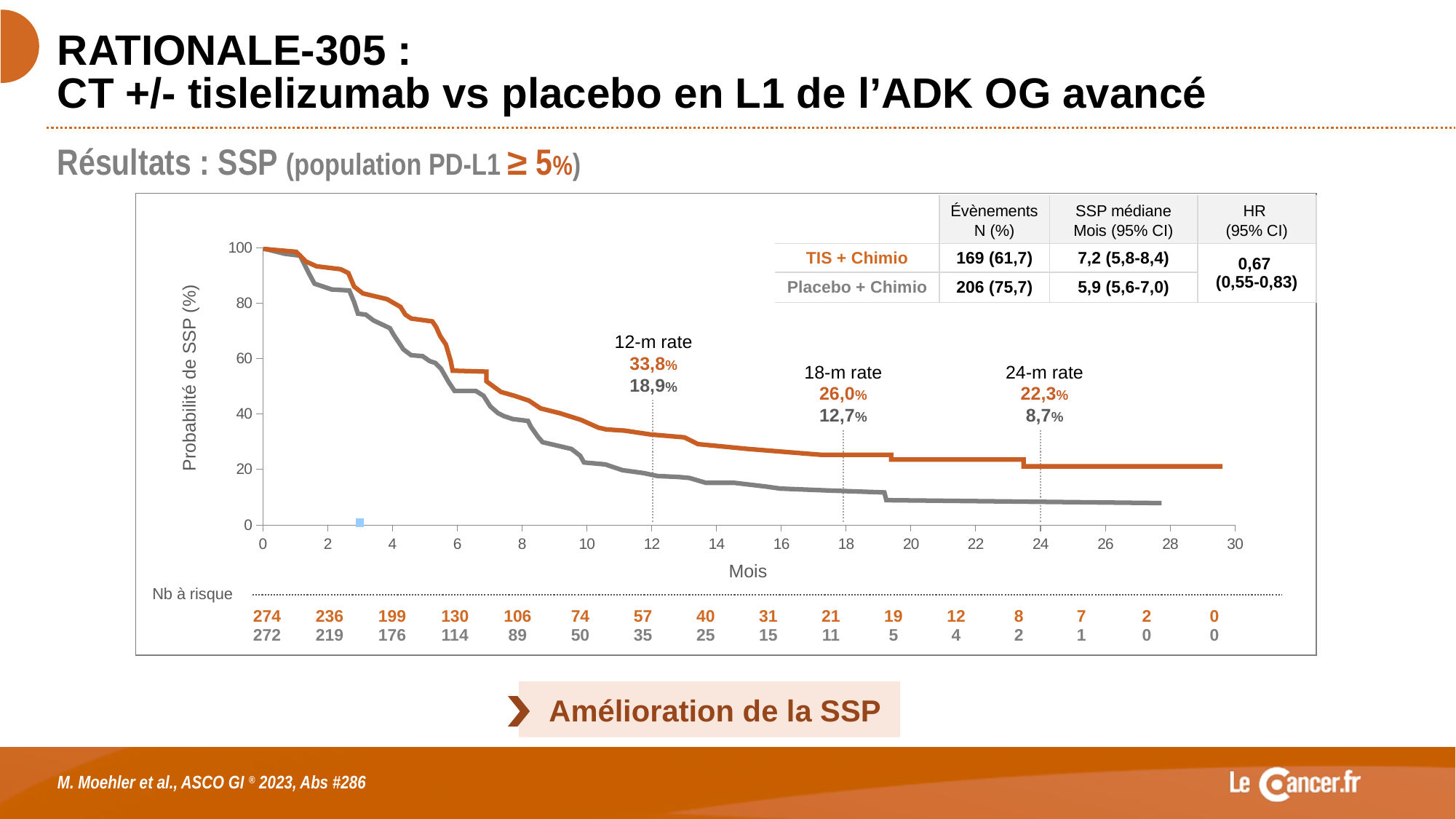
How many patients were at risk in the Placebo + Chimio arm at 10 months? 50 Which arm has the higher number of events, N (%)? Placebo + Chimio Do the SSP probability curves rise or fall along the x axis? fall What is the 12-month SSP rate for the TIS + Chimio arm? 33,8% What is the hazard ratio (95% CI) shown in the table? 0,67 (0,55-0,83) What is the label of the x axis of the chart? Mois How many patients were at risk in the TIS + Chimio arm at 0 months? 274 What is the 18-month SSP rate for the Placebo + Chimio arm? 12,7% What is the 24-month SSP rate for the TIS + Chimio arm? 22,3% Which arm has the higher 24-month SSP rate? TIS + Chimio What is the median SSP in months for the Placebo + Chimio arm? 5,9 (5,6-7,0) What is the difference between the 12-month SSP rates of the TIS + Chimio and Placebo + Chimio arms? 14,9%